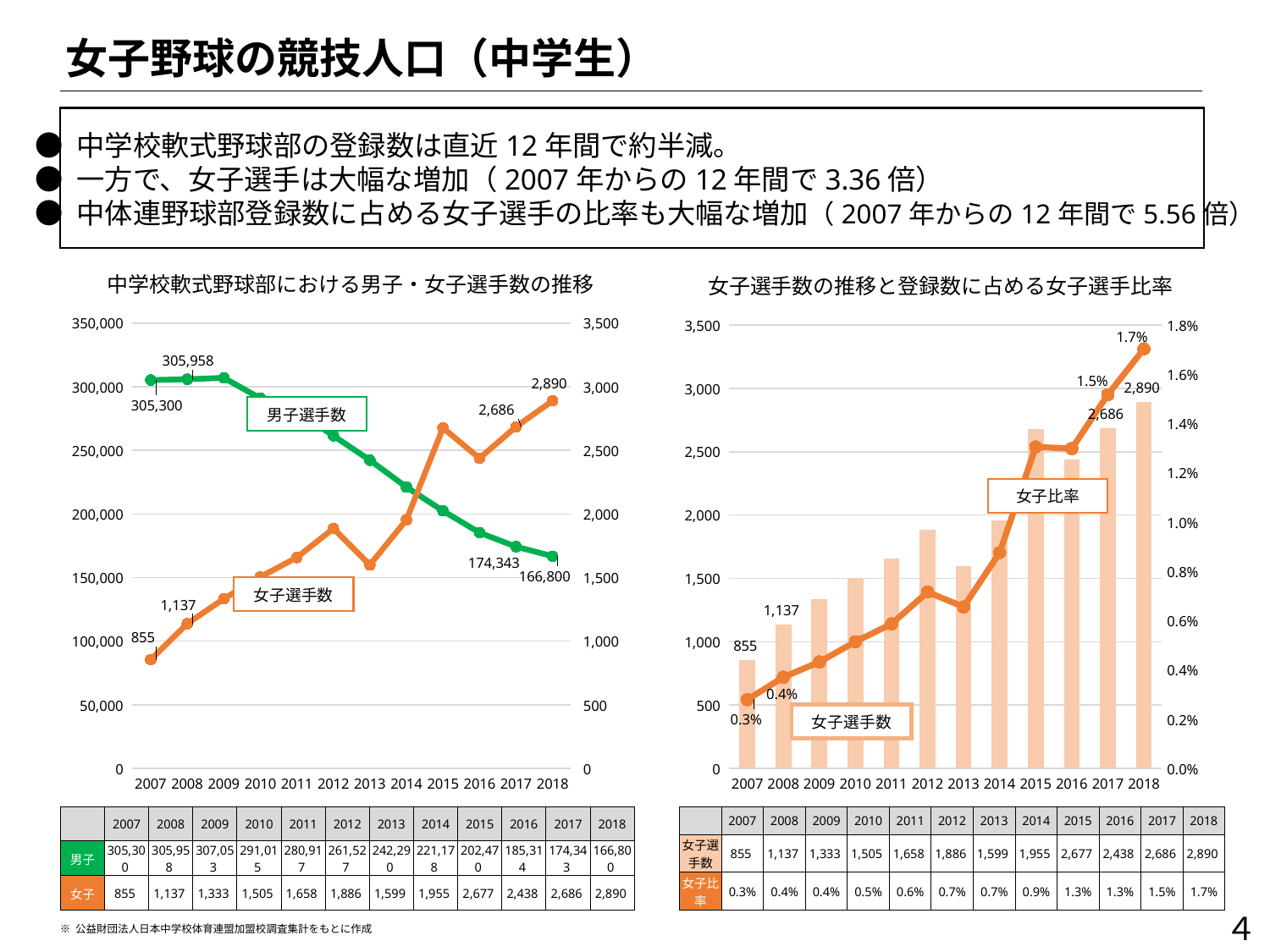
In the left chart (中学校軟式野球部における男子・女子選手数の推移), in which year is 女子選手数 highest? 2018 In the left chart (中学校軟式野球部における男子・女子選手数の推移), does 男子選手数 rise or fall from 2009 to 2018? fall In the left chart (中学校軟式野球部における男子・女子選手数の推移), in which year is 男子選手数 lowest? 2018 In the left chart (中学校軟式野球部における男子・女子選手数の推移), how many years are plotted on the x axis? 12 In the right chart (女子選手数の推移と登録数に占める女子選手比率), what is the 女子比率 value for 2007? 0.3% In the left chart (中学校軟式野球部における男子・女子選手数の推移), what is the value of 女子選手数 in 2018? 2,890 In the left chart (中学校軟式野球部における男子・女子選手数の推移), what is the difference between 女子選手数 in 2018 and in 2007? 2,035 In the right chart (女子選手数の推移と登録数に占める女子選手比率), is the 女子選手数 bar for 2012 greater or less than 1,500? greater In the left chart (中学校軟式野球部における男子・女子選手数の推移), what is the value of 男子選手数 in 2007? 305,300 What type of chart is the left chart (中学校軟式野球部における男子・女子選手数の推移)? line chart In the right chart (女子選手数の推移と登録数に占める女子選手比率), what is the 女子比率 value for 2018? 1.7% In the right chart (女子選手数の推移と登録数に占める女子選手比率), which is larger, 女子選手数 in 2015 or in 2016? 2015